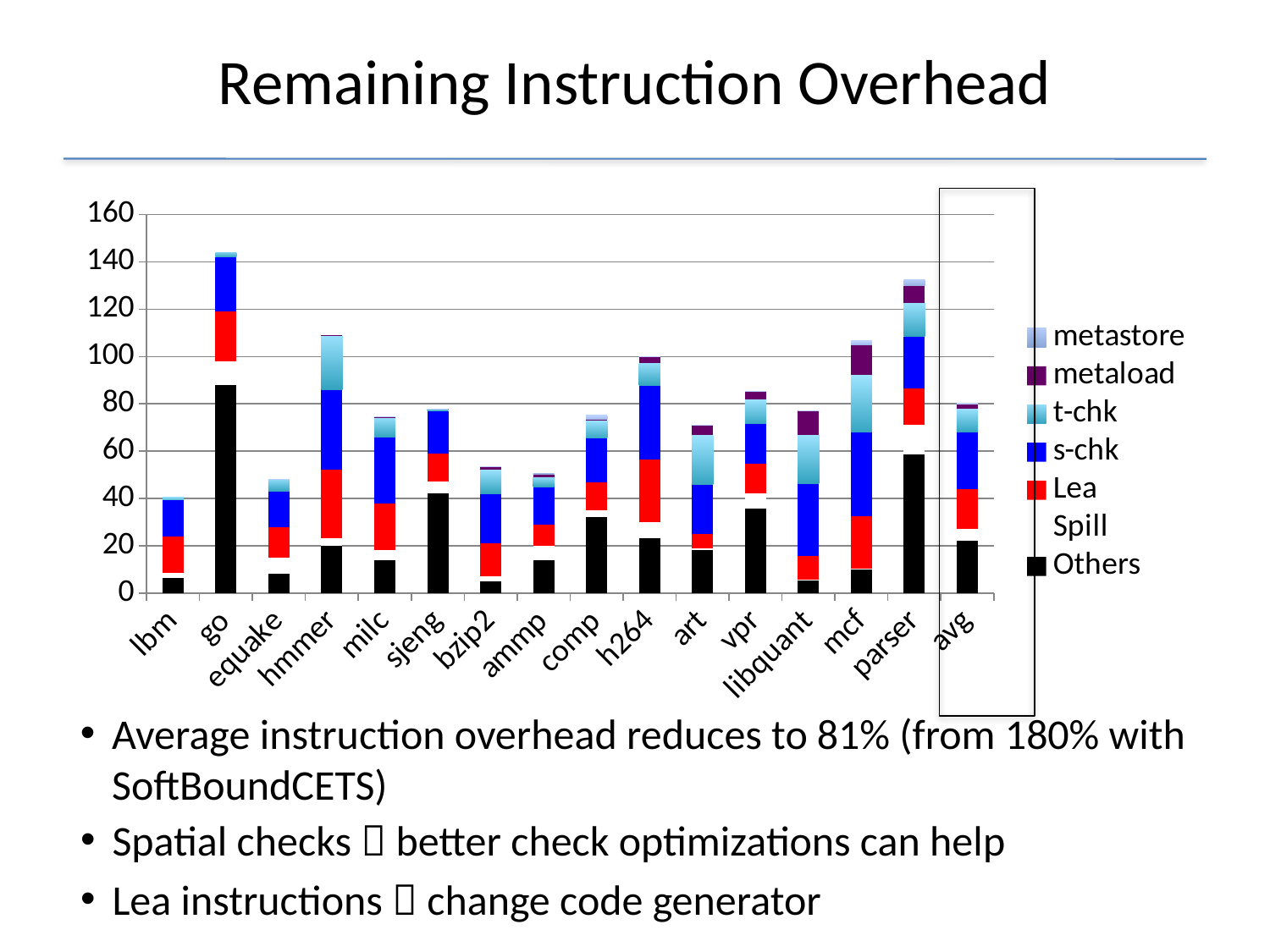
Which category has the highest total bar in the chart? go Is the total bar for parser greater or less than 120? greater What is the title of the chart on the slide? Remaining Instruction Overhead Is the total bar for avg greater or less than 60? greater Which has the larger total bar, go or parser? go How many series does the chart's legend list? 7 Which series is shown in black in the chart's legend? Others Is the total bar for go greater or less than 120? greater What kind of chart is shown on the slide? stacked bar chart Which category has the lowest total bar in the chart? lbm How many categories are shown along the x axis of the chart? 16